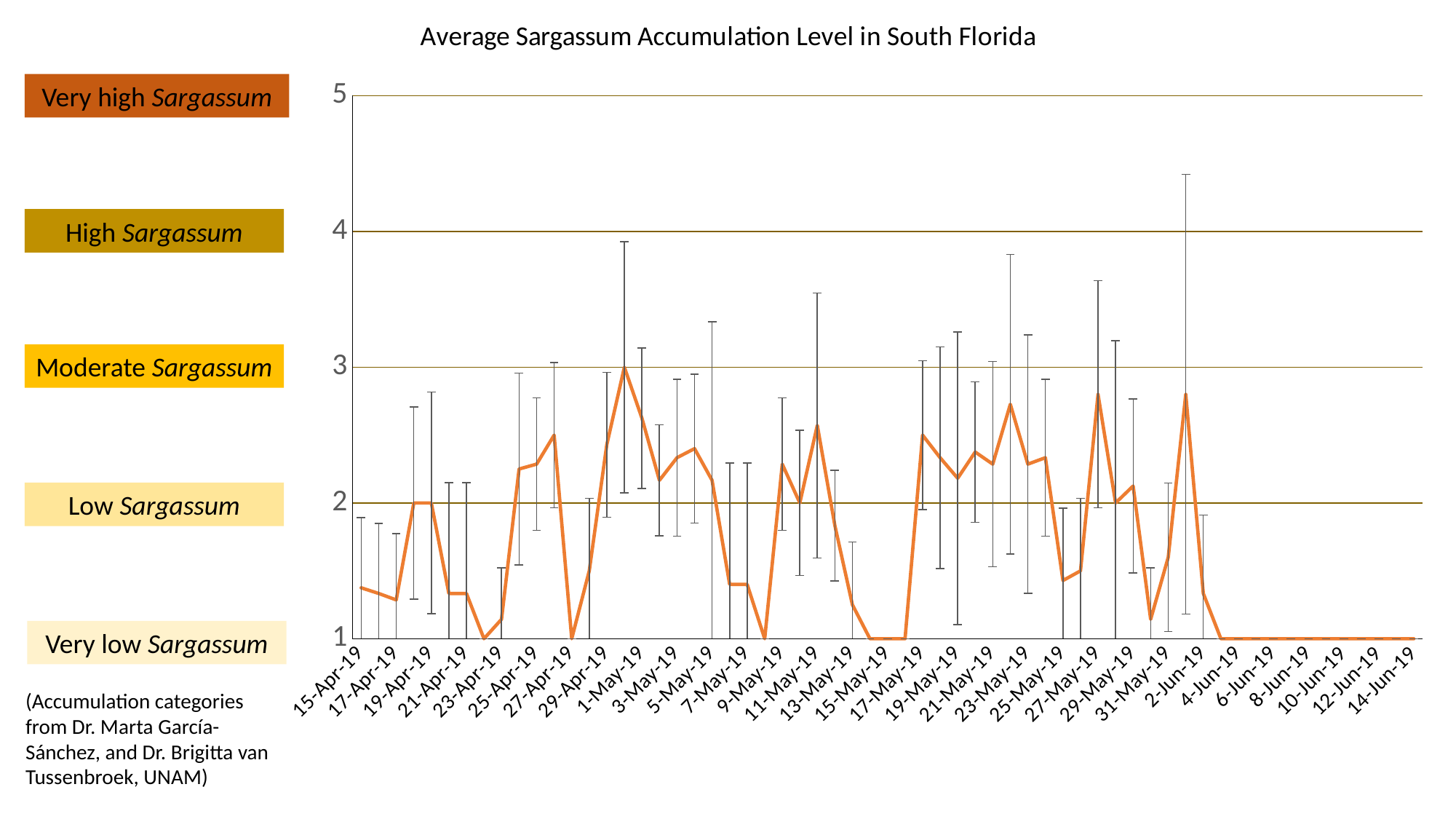
What is the highest value shown on the y axis? 5 Is the value for 11-May-19 greater or less than 2? greater What is the title of the chart? Average Sargassum Accumulation Level in South Florida What is the value of the line on 14-Jun-19? 1 What kind of chart is shown on the slide? line chart Which has the larger value, 1-May-19 or 15-May-19? 1-May-19 Does the line rise or fall from 1-May-19 to 3-May-19? fall Is the value for 27-Apr-19 greater or less than 2? less Is the value for 23-Apr-19 greater or less than 2? less What is the value of the line on 15-May-19? 1